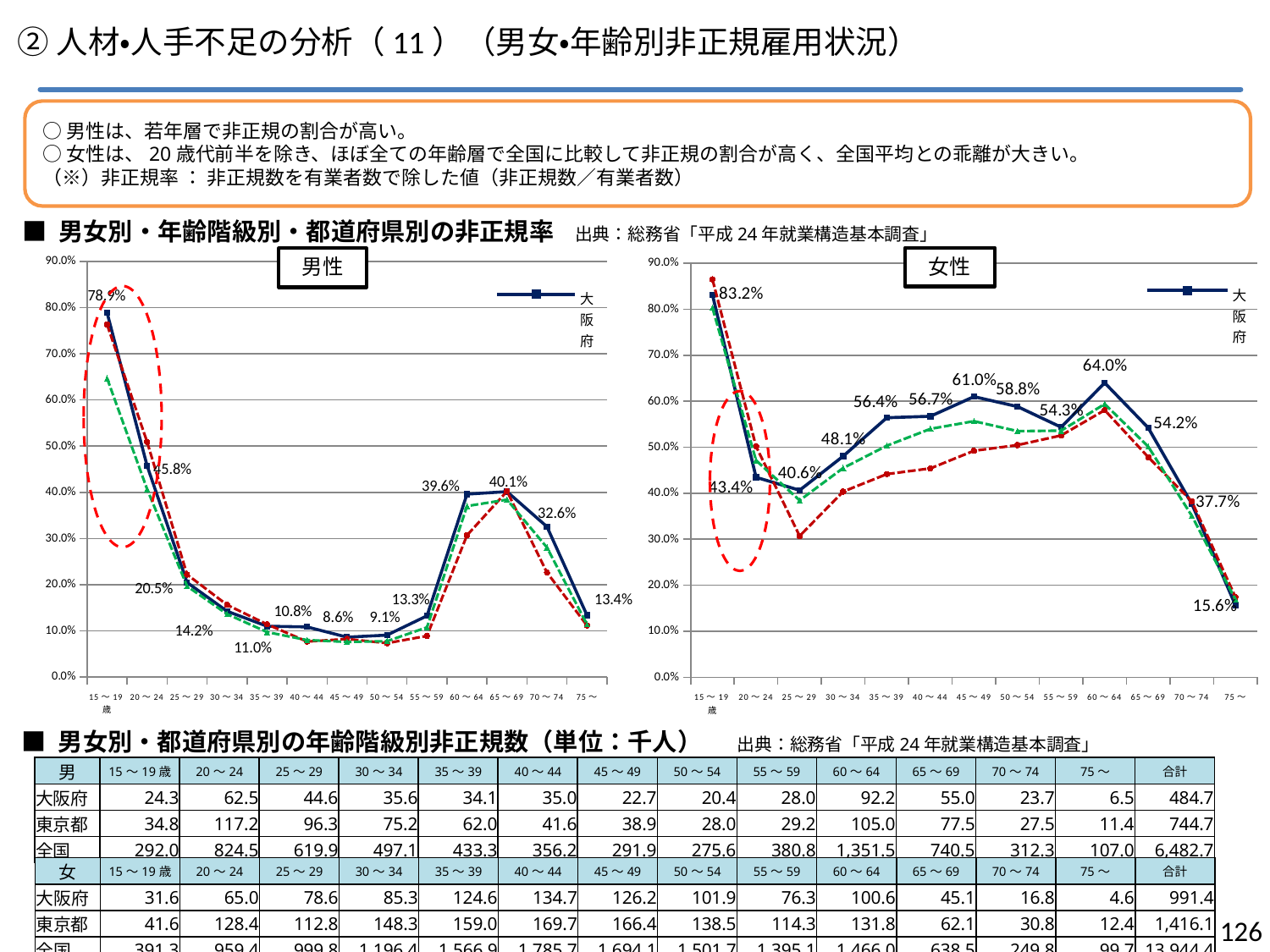
What kind of chart is the 女性 chart? Line chart In the 女性 chart, which age group has the highest 大阪府 value? 15～19歳 In the 女性 chart, which age group has the lowest 大阪府 value? 75～ In the 女性 chart, what is the difference between the 大阪府 values for 60～64 and 55～59? 9.7 percentage points In the 男性 chart, what is the 大阪府 value for the 15～19歳 age group? 78.9% How many age groups are plotted along the x axis of the 男性 chart? 13 In the 男性 chart, which is larger for 大阪府: the 60～64 value or the 65～69 value? 65～69 In the 男性 chart, which age group has the lowest 大阪府 value? 45～49 In the 女性 chart, what is the 大阪府 value for the 60～64 age group? 64.0% In the 男性 chart, what is the 大阪府 value for the 70～74 age group? 32.6% In the 男性 chart, does the 大阪府 line rise or fall from 15～19歳 to 45～49? Fall In the 女性 chart, which is larger for 大阪府: the 45～49 value or the 50～54 value? 45～49